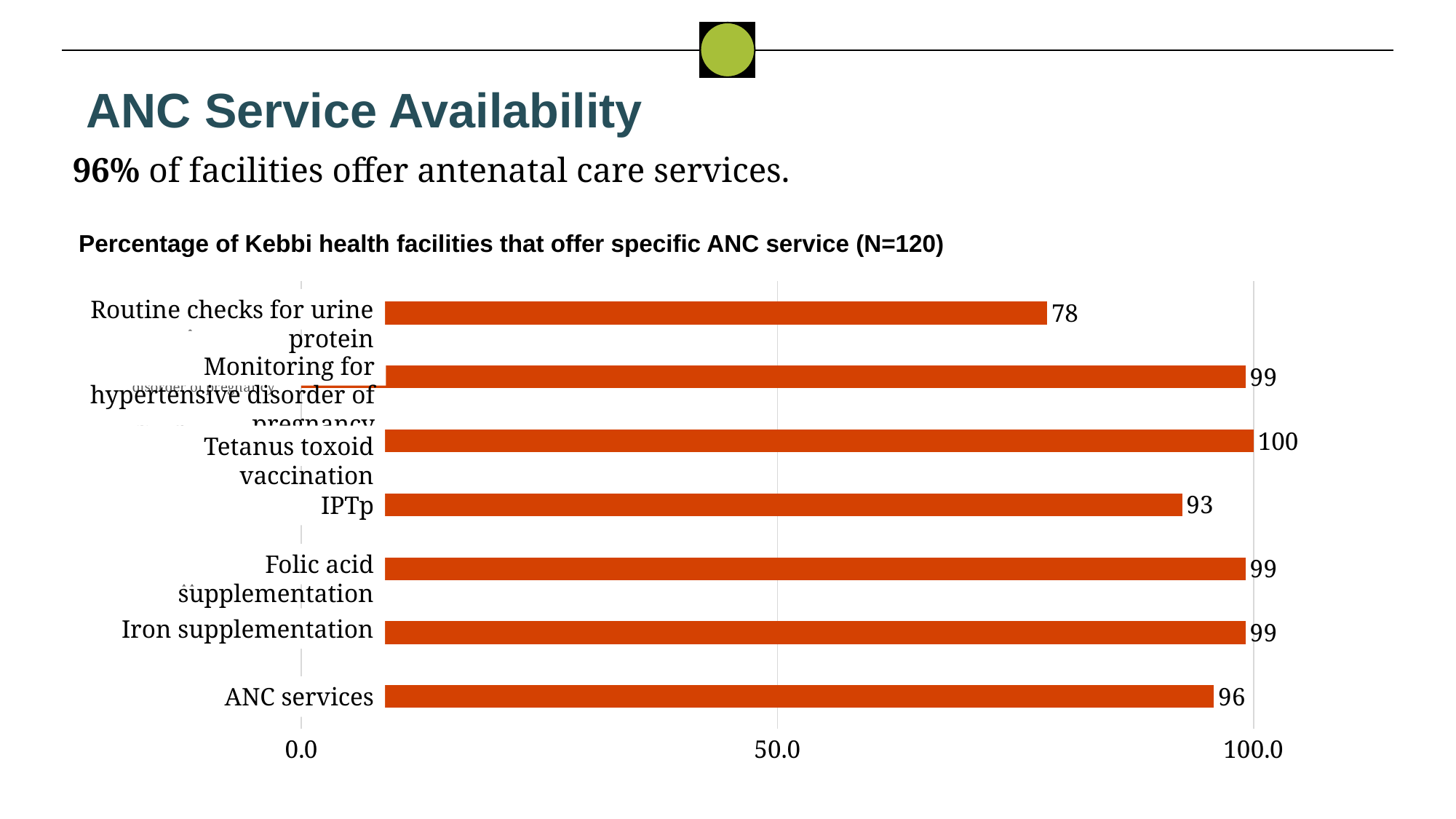
Which ANC service has the highest percentage of facilities offering it? Tetanus toxoid vaccination What percentage of facilities offer routine checks for urine protein? 78 What kind of chart is shown on the slide? Bar chart What is the value shown for ANC services? 96 How many ANC services are shown as bars in the chart? 7 What is the value shown for Tetanus toxoid vaccination? 100 What is the difference between the values for ANC services and IPTp? 3 What is the value shown for IPTp? 93 Which is larger, the value for IPTp or the value for Iron supplementation? Iron supplementation Which ANC service has the lowest percentage of facilities offering it? Routine checks for urine protein What is the difference between the values for Tetanus toxoid vaccination and Routine checks for urine protein? 22 What is the sample size (N) stated in the chart title? 120